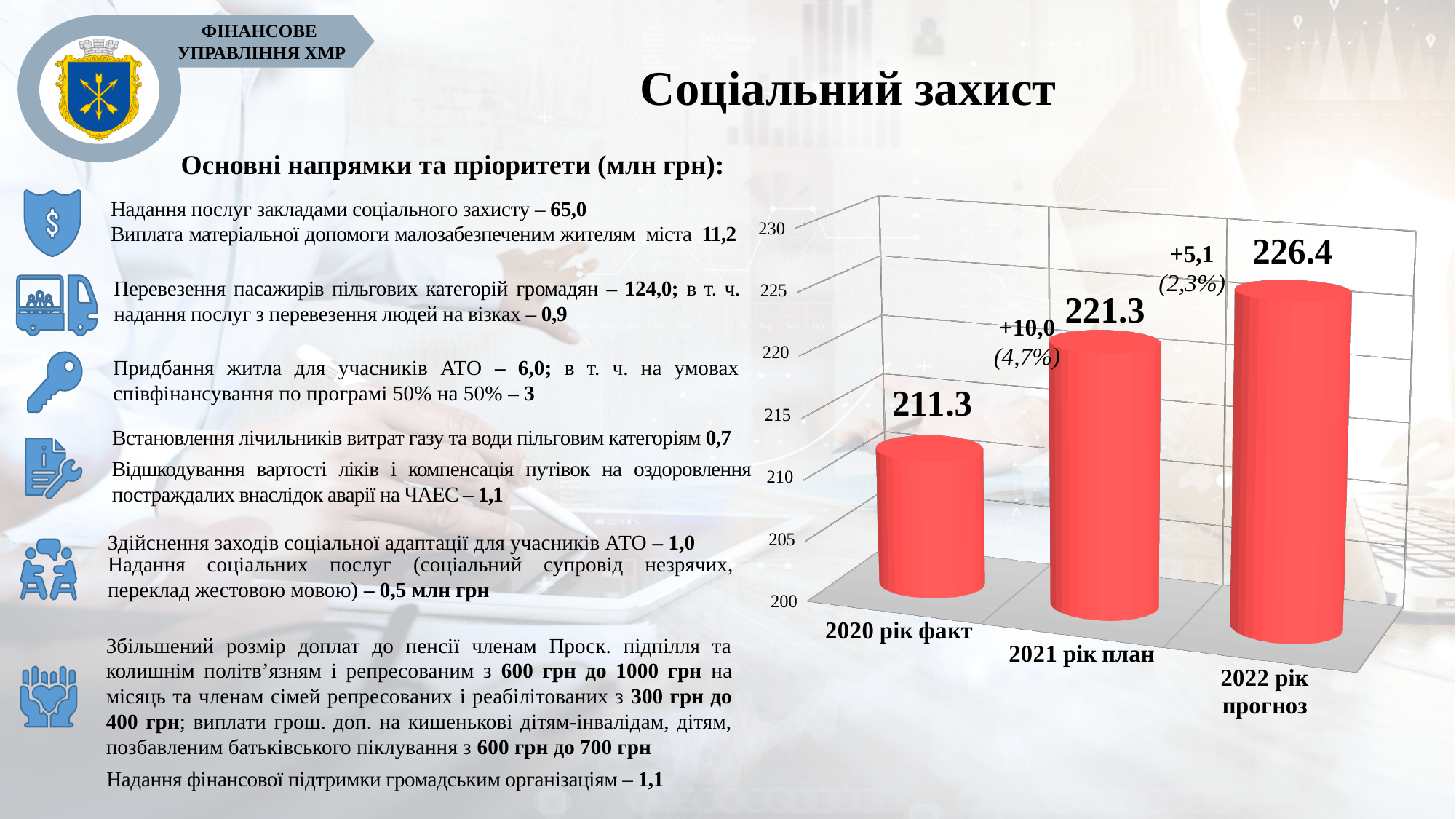
Which category has the lowest value? 2020 рік факт What is the difference between the values for 2022 рік прогноз and 2021 рік план? 5.1 What is the value for 2020 рік факт? 211.3 Do the values rise or fall from 2020 рік факт to 2022 рік прогноз? rise What kind of chart is shown on the slide? bar chart What is the value for 2022 рік прогноз? 226.4 What is the value for 2021 рік план? 221.3 Is the value for 2022 рік прогноз greater or less than 225? greater How many categories are shown in the chart? 3 What is the difference between the values for 2021 рік план and 2020 рік факт? 10.0 Which is larger, the value for 2021 рік план or the value for 2020 рік факт? 2021 рік план Which category has the highest value? 2022 рік прогноз